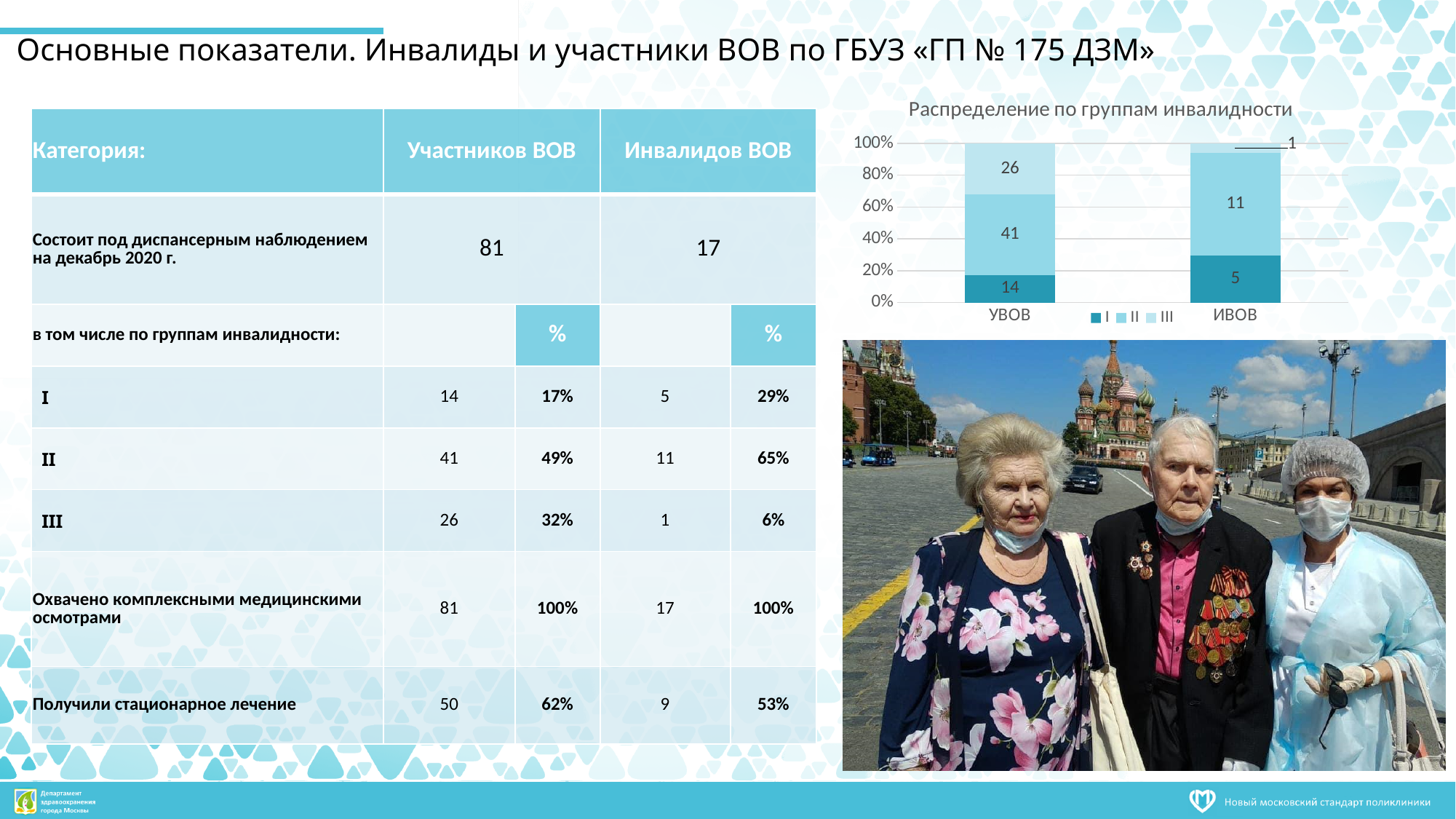
What is the total of the stacked bar for ИВОВ in the chart? 17 What is the value of series II for ИВОВ in the chart? 11 What is the value of series III for ИВОВ in the chart? 1 What is the title of the chart on the slide? Распределение по группам инвалидности How many series does the chart legend list? 3 What is the value of series II for УВОВ in the chart? 41 Which series has the largest value for УВОВ in the chart? II What is the value of series I for УВОВ in the chart? 14 How many categories are shown on the x axis of the chart? 2 What is the difference between the series II value and the series I value for ИВОВ in the chart? 6 What type of chart is shown on the slide? stacked bar chart What is the total of the stacked bar for УВОВ in the chart? 81